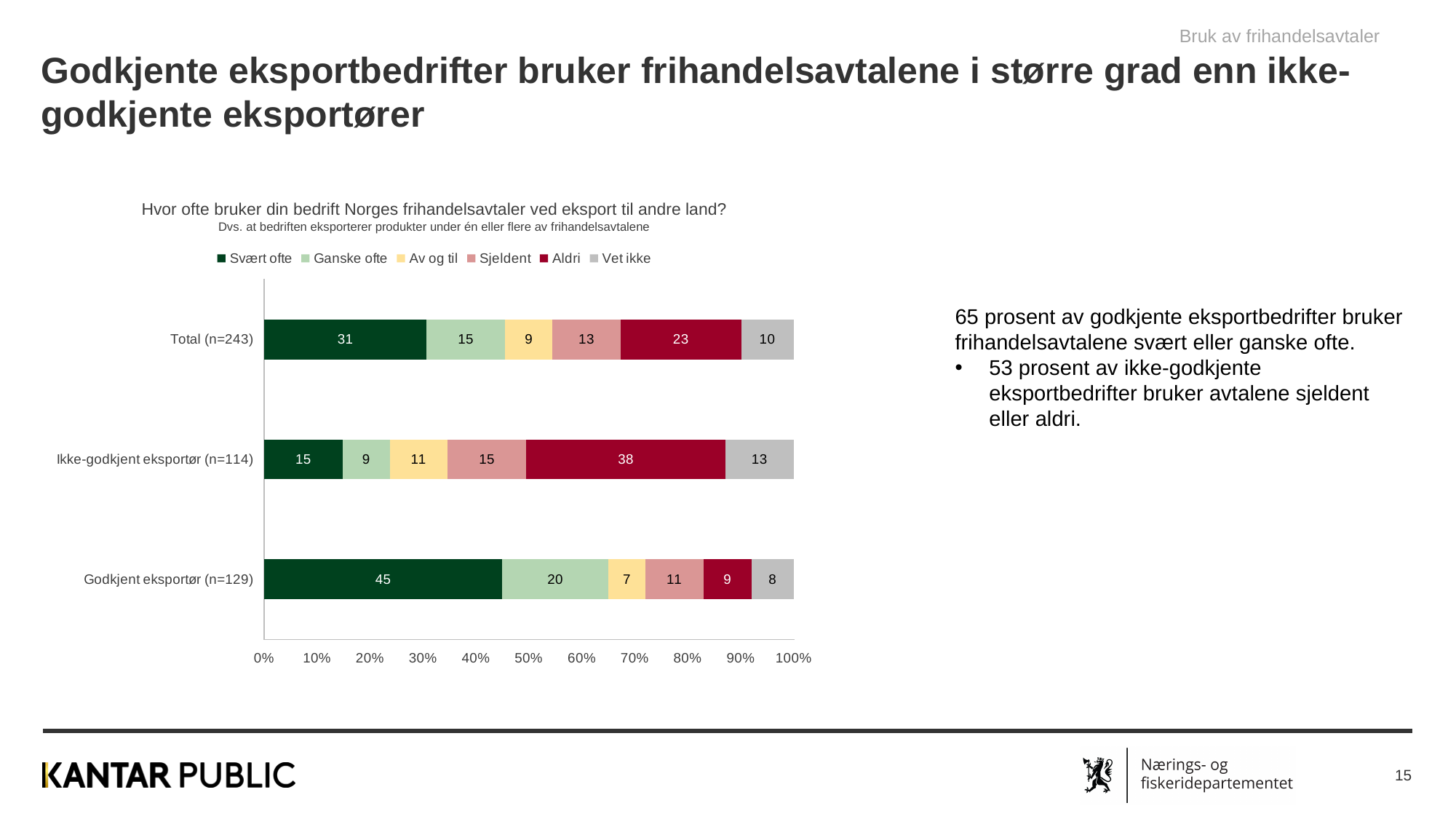
What is the value for "Aldri" for Ikke-godkjent eksportør (n=114)? 38 Which category has the highest value for "Svært ofte"? Godkjent eksportør (n=129) How many categories (bars) are shown in the chart? 3 What is the difference between the "Aldri" values for Ikke-godkjent eksportør (n=114) and Godkjent eksportør (n=129)? 29 What is the value for "Svært ofte" for Godkjent eksportør (n=129)? 45 How many series does the legend list? 6 Which category has the lowest value for "Aldri"? Godkjent eksportør (n=129) Which is larger: the "Ganske ofte" value for Total (n=243) or for Ikke-godkjent eksportør (n=114)? Total (n=243) What is the value for "Vet ikke" for Total (n=243)? 10 What kind of chart is shown on the slide? Stacked bar chart What is the combined value of "Svært ofte" and "Ganske ofte" for Godkjent eksportør (n=129)? 65 Which legend entry is shown in dark red? Aldri